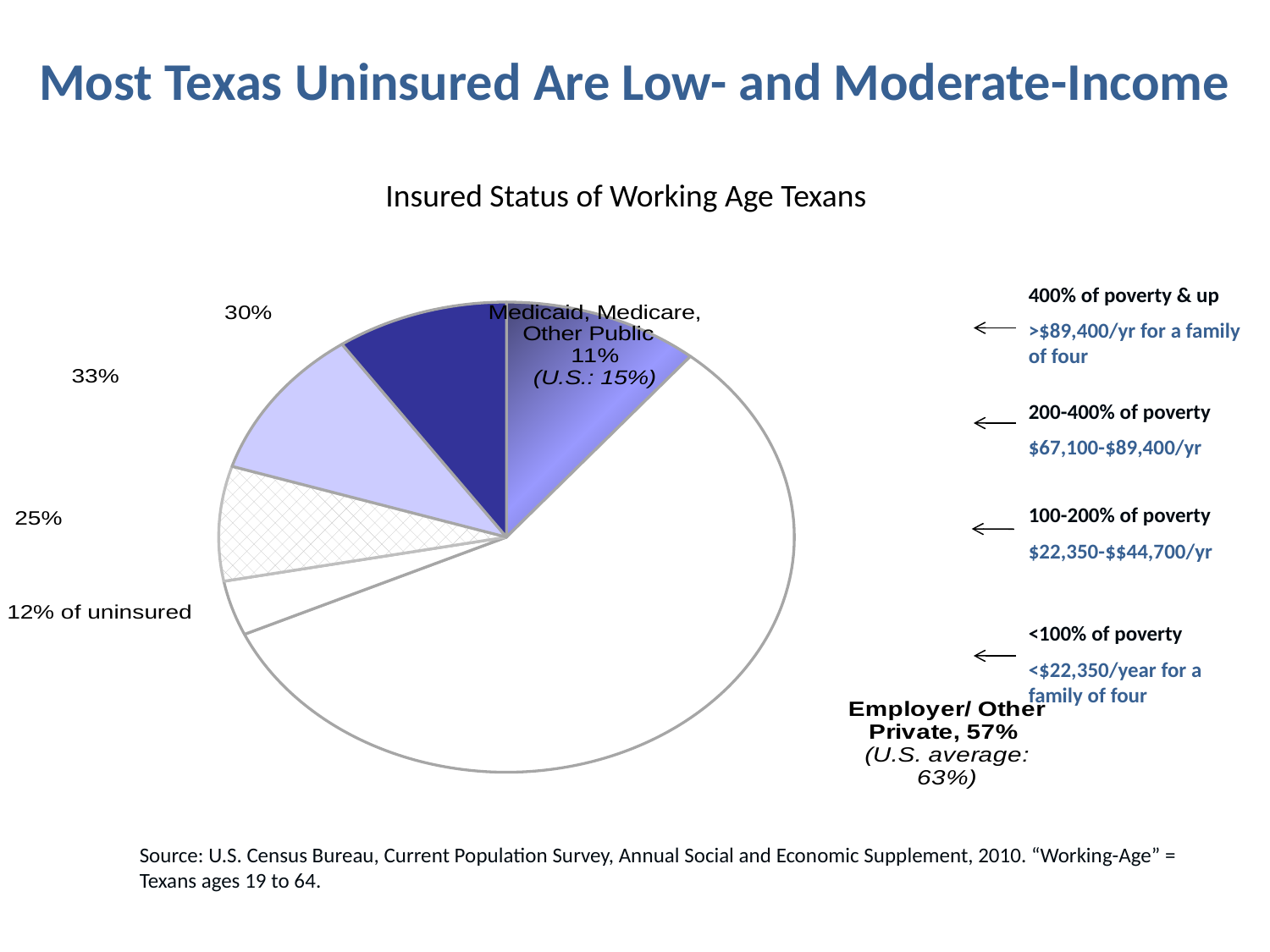
What is the U.S. figure shown for Medicaid, Medicare, Other Public coverage? 15% What kind of chart is shown on the slide? pie chart What share of working age Texans are covered by Medicaid, Medicare, or Other Public insurance? 11% What is the difference in percentage points between the Employer/Other Private share (57%) and the Medicaid, Medicare, Other Public share (11%)? 46 percentage points Which slice of the pie is the largest? Employer/ Other Private Which is larger, the Employer/Other Private share or the Medicaid, Medicare, Other Public share? Employer/ Other Private What share of working age Texans have Employer/Other Private insurance? 57% What is the largest percentage labeled among the uninsured slices? 33% What is the smallest percentage labeled among the uninsured slices? 12% What is the title of the chart? Insured Status of Working Age Texans What is the U.S. average for Employer/Other Private coverage shown on the chart? 63% How many slices does the pie chart have? 6